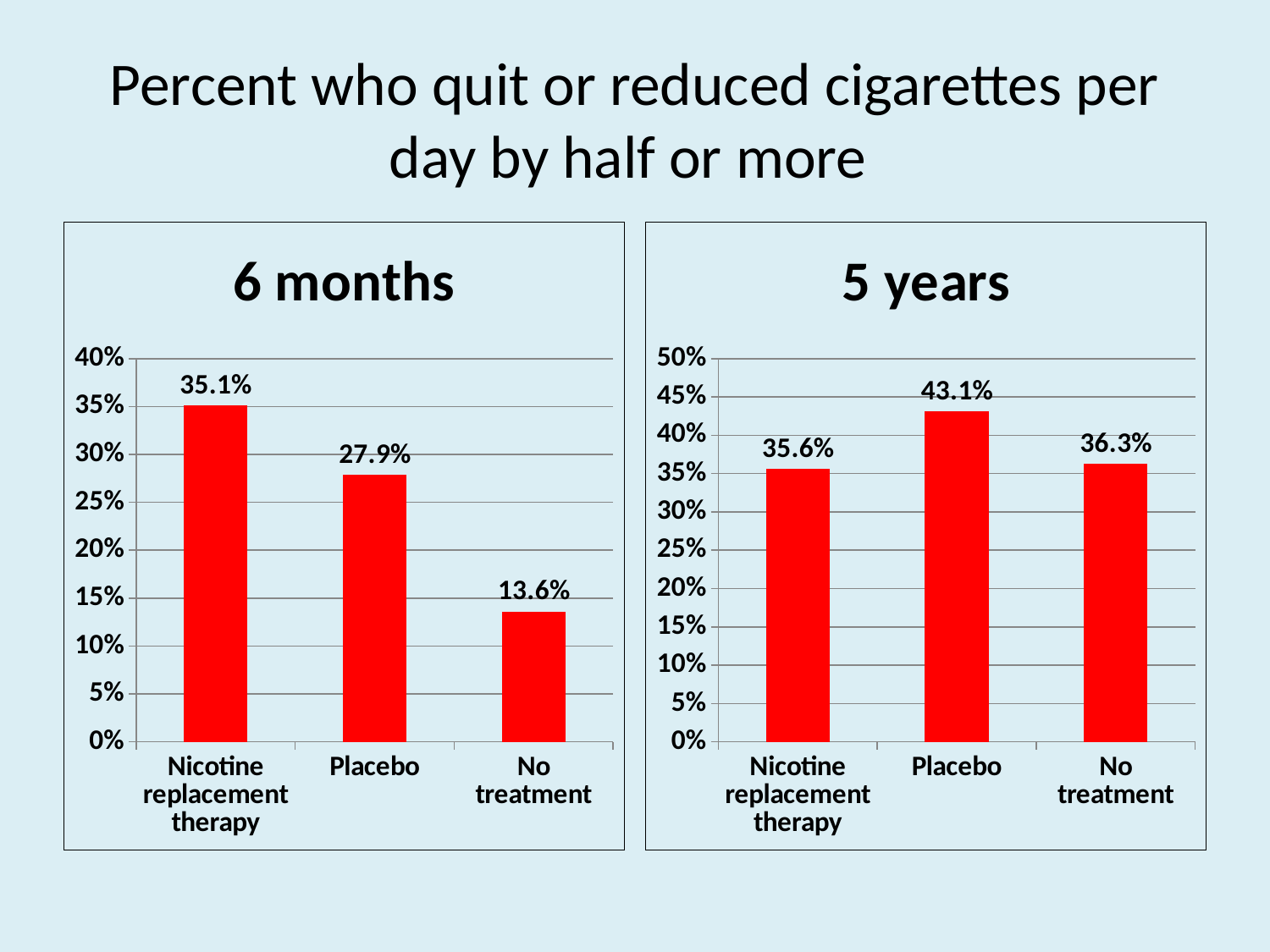
In the '5 years' chart, what is the value for Nicotine replacement therapy? 35.6% In the '5 years' chart, what is the difference between the Placebo value and the No treatment value? 6.8% How many categories are shown in the '5 years' chart? 3 In the '6 months' chart, do the values rise or fall from left to right across the categories? fall In the '6 months' chart, which is larger, the value for Placebo or the value for No treatment? Placebo In the '5 years' chart, what is the value for Placebo? 43.1% In the '6 months' chart, which category has the highest value? Nicotine replacement therapy In the '5 years' chart, which category has the lowest value? Nicotine replacement therapy In the '6 months' chart, what is the value for Nicotine replacement therapy? 35.1% In the '6 months' chart, what is the value for No treatment? 13.6% What kind of chart is the '6 months' chart? bar chart In the '6 months' chart, what is the difference between the Placebo value and the No treatment value? 14.3%